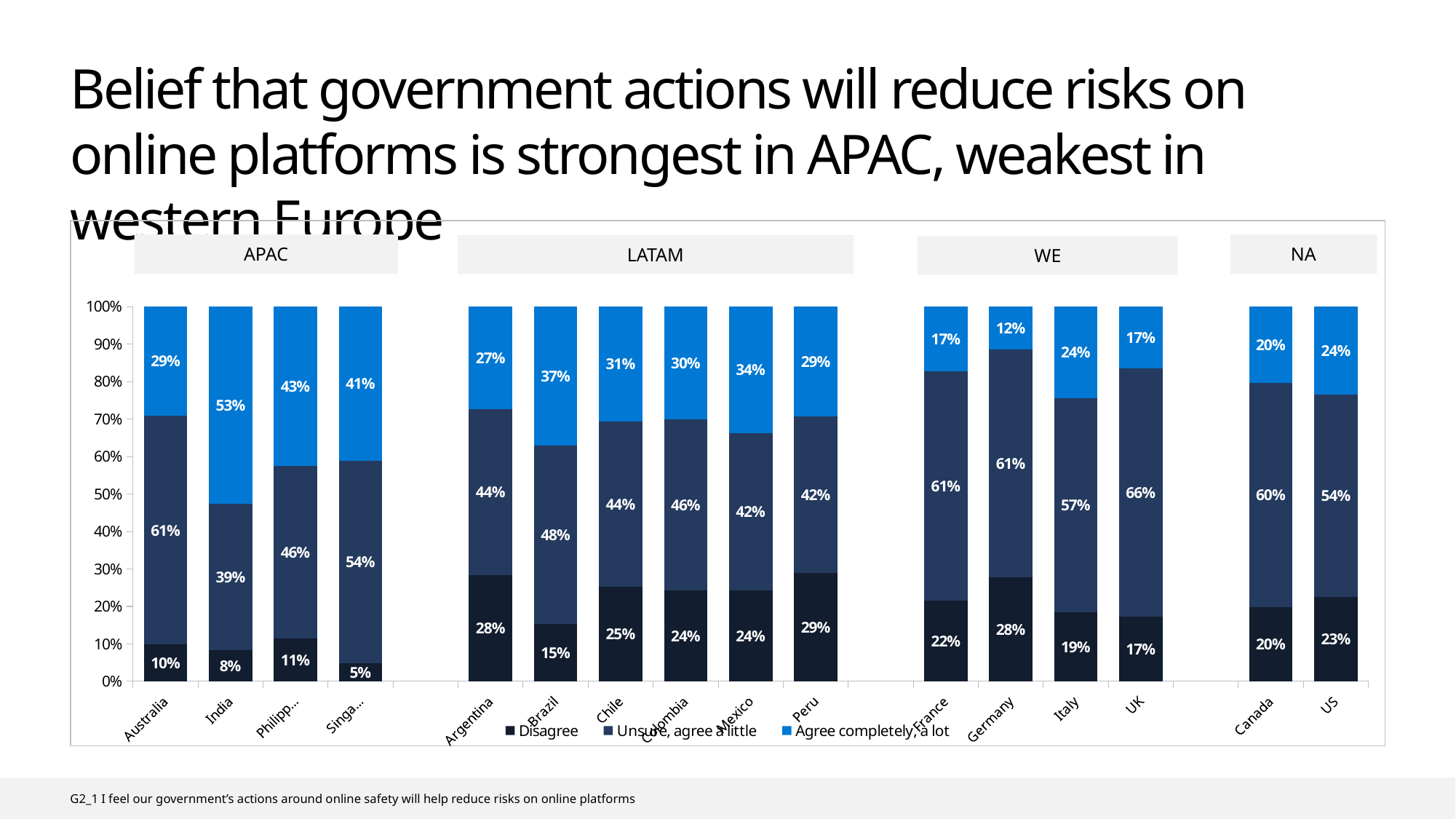
Is the 'Disagree' value for Brazil greater or less than 20%? less Which country has the lowest 'Agree completely, a lot' share? Germany Which has a larger 'Agree completely, a lot' share, Canada or the US? US What is the difference in percentage points between India's and Germany's 'Agree completely, a lot' values? 41 percentage points What percentage of respondents in Peru disagree? 29% How many series does the legend list? 3 What is the 'Agree completely, a lot' value for Germany? 12% What kind of chart is shown on the slide? Stacked bar chart What is the 'Unsure, agree a little' value for the UK? 66% Which country has the highest 'Agree completely, a lot' share? India How many countries are shown on the chart? 16 What percentage of respondents in India agree completely or a lot that government actions will reduce risks on online platforms? 53%